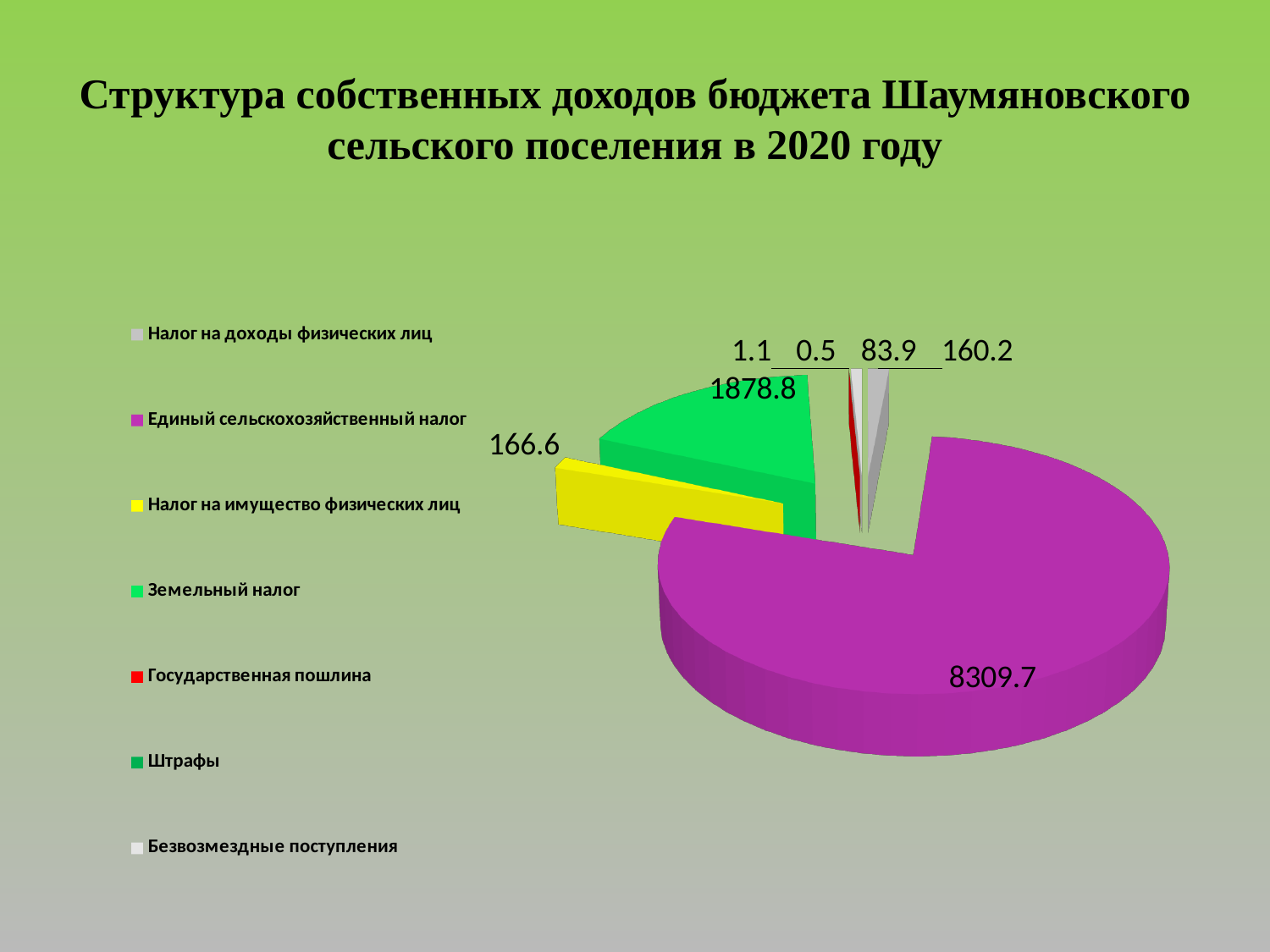
Which category has the largest slice of the pie? Единый сельскохозяйственный налог What is the value for Земельный налог? 1878.8 What type of chart is shown on the slide? Pie chart What is the value for Налог на имущество физических лиц? 166.6 What is the value for Налог на доходы физических лиц? 160.2 Which is larger, the value for Земельный налог or the value for Налог на имущество физических лиц? Земельный налог What colour is the slice for Единый сельскохозяйственный налог? Purple What is the value for Безвозмездные поступления? 83.9 Which category has the smallest value? Штрафы What is the difference between the values for Земельный налог and Налог на имущество физических лиц? 1712.2 What is the value for Единый сельскохозяйственный налог? 8309.7 How many categories does the legend list? 7